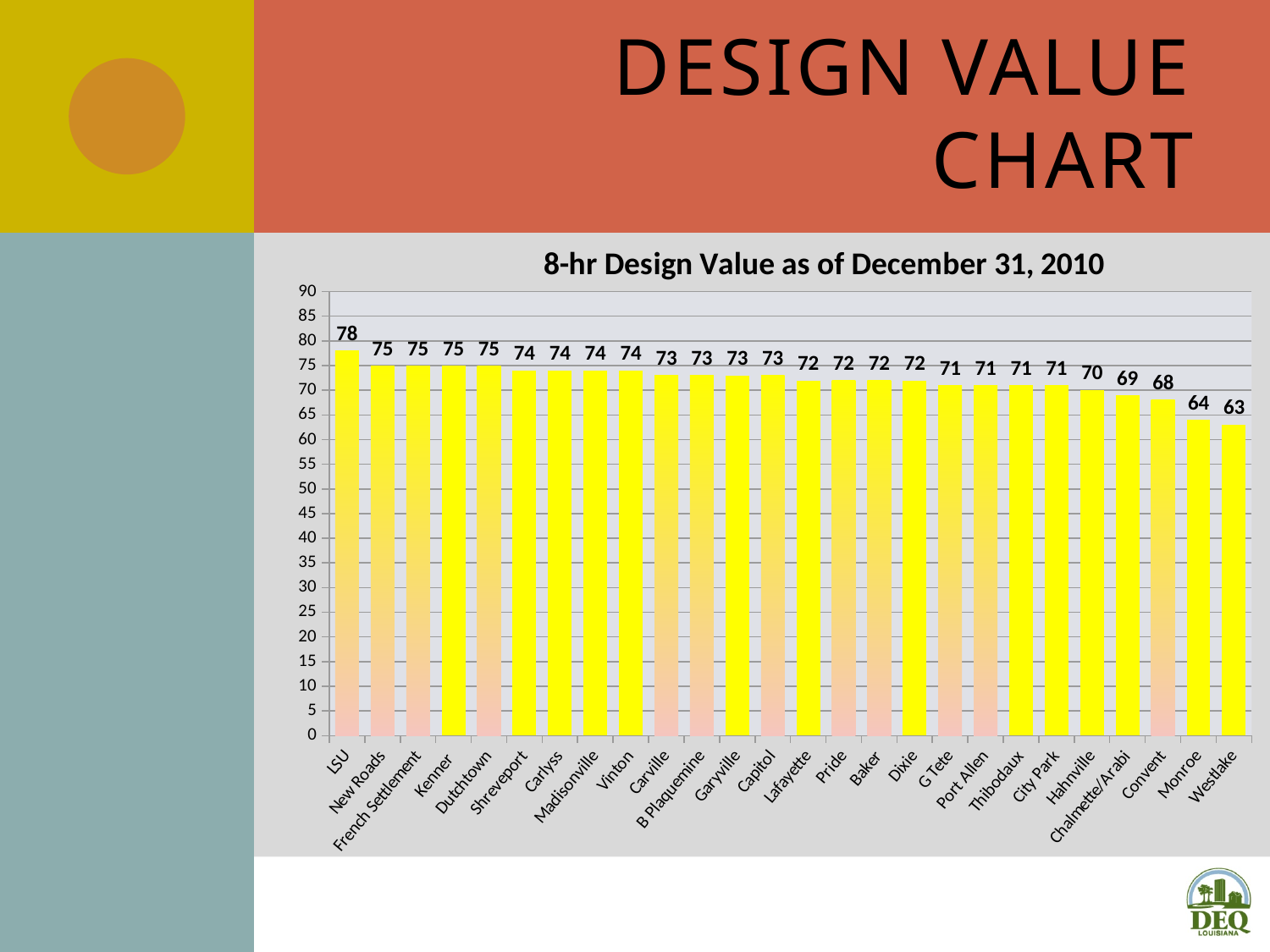
What kind of chart is shown on the slide? Bar chart What is the 8-hr design value for Westlake? 63 What is the 8-hr design value for LSU? 78 What is the title of the chart? 8-hr Design Value as of December 31, 2010 Which site has the lowest 8-hr design value? Westlake What is the difference between the design values for LSU and Westlake? 15 What is the difference between the design values for Convent and Monroe? 4 Which site has the highest 8-hr design value? LSU Which has a higher design value, Shreveport or Chalmette/Arabi? Shreveport What is the 8-hr design value for Hahnville? 70 What is the 8-hr design value for Monroe? 64 How many sites are shown on the chart? 26